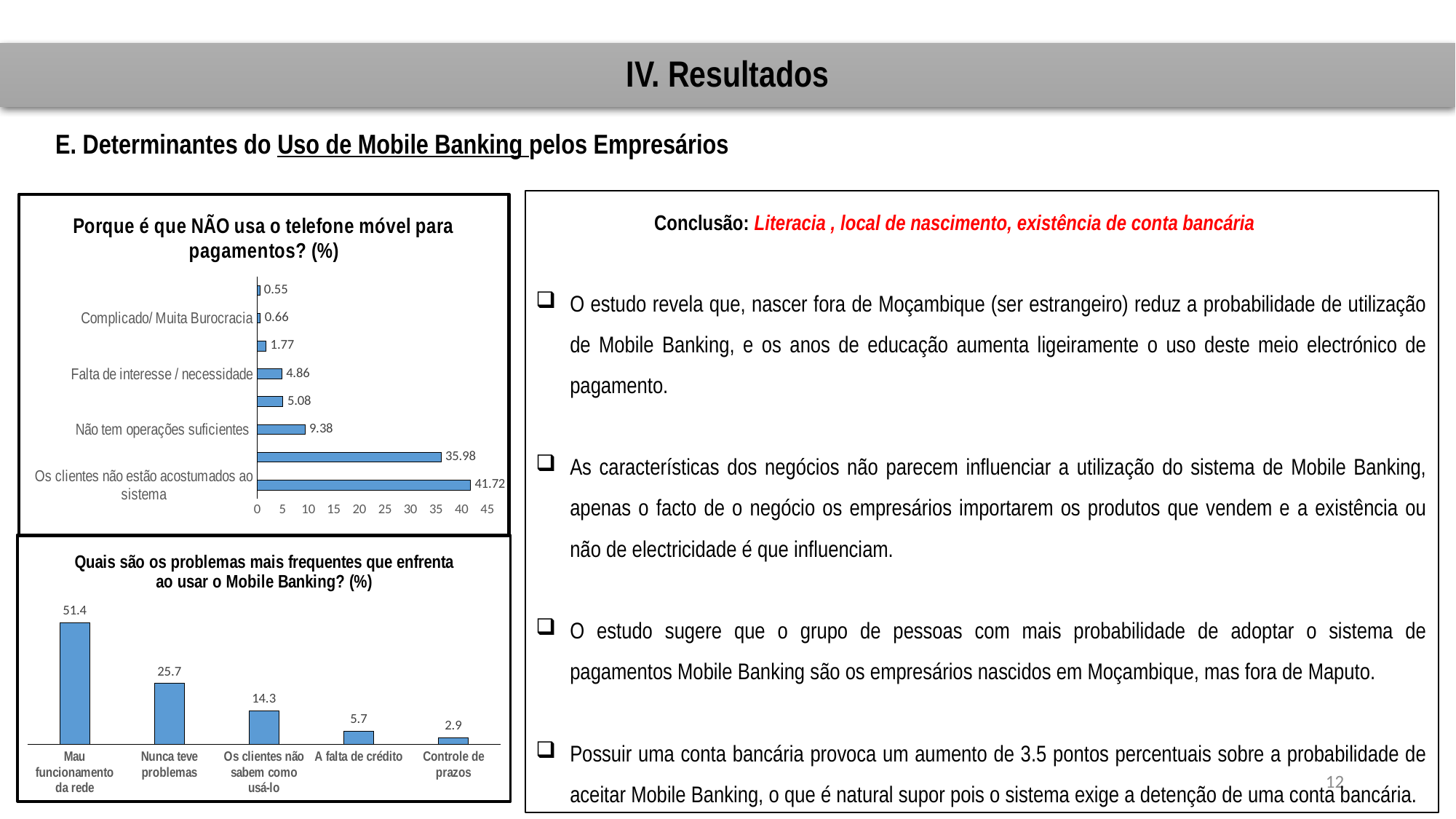
In the bottom chart 'Quais são os problemas mais frequentes que enfrenta ao usar o Mobile Banking? (%)', how many categories are shown? 5 In the bottom chart 'Quais são os problemas mais frequentes que enfrenta ao usar o Mobile Banking? (%)', what is the difference between 'Nunca teve problemas' and 'Os clientes não sabem como usá-lo'? 11.4 In the top chart 'Porque é que NÃO usa o telefone móvel para pagamentos? (%)', what is the value for 'Falta de interesse / necessidade'? 4.86 In the top chart 'Porque é que NÃO usa o telefone móvel para pagamentos? (%)', how many bars are plotted? 8 In the bottom chart 'Quais são os problemas mais frequentes que enfrenta ao usar o Mobile Banking? (%)', which category has the lowest value? Controle de prazos In the top chart 'Porque é que NÃO usa o telefone móvel para pagamentos? (%)', what is the value for 'Complicado/ Muita Burocracia'? 0.66 In the top chart 'Porque é que NÃO usa o telefone móvel para pagamentos? (%)', what is the difference between the two largest values, 41.72 and 35.98? 5.74 In the top chart 'Porque é que NÃO usa o telefone móvel para pagamentos? (%)', what is the value for 'Os clientes não estão acostumados ao sistema'? 41.72 What kind of chart is the top chart 'Porque é que NÃO usa o telefone móvel para pagamentos? (%)'? Bar chart In the top chart 'Porque é que NÃO usa o telefone móvel para pagamentos? (%)', what is the value for 'Não tem operações suficientes'? 9.38 In the bottom chart 'Quais são os problemas mais frequentes que enfrenta ao usar o Mobile Banking? (%)', what is the value for 'Mau funcionamento da rede'? 51.4 In the bottom chart 'Quais são os problemas mais frequentes que enfrenta ao usar o Mobile Banking? (%)', which category has the highest value? Mau funcionamento da rede